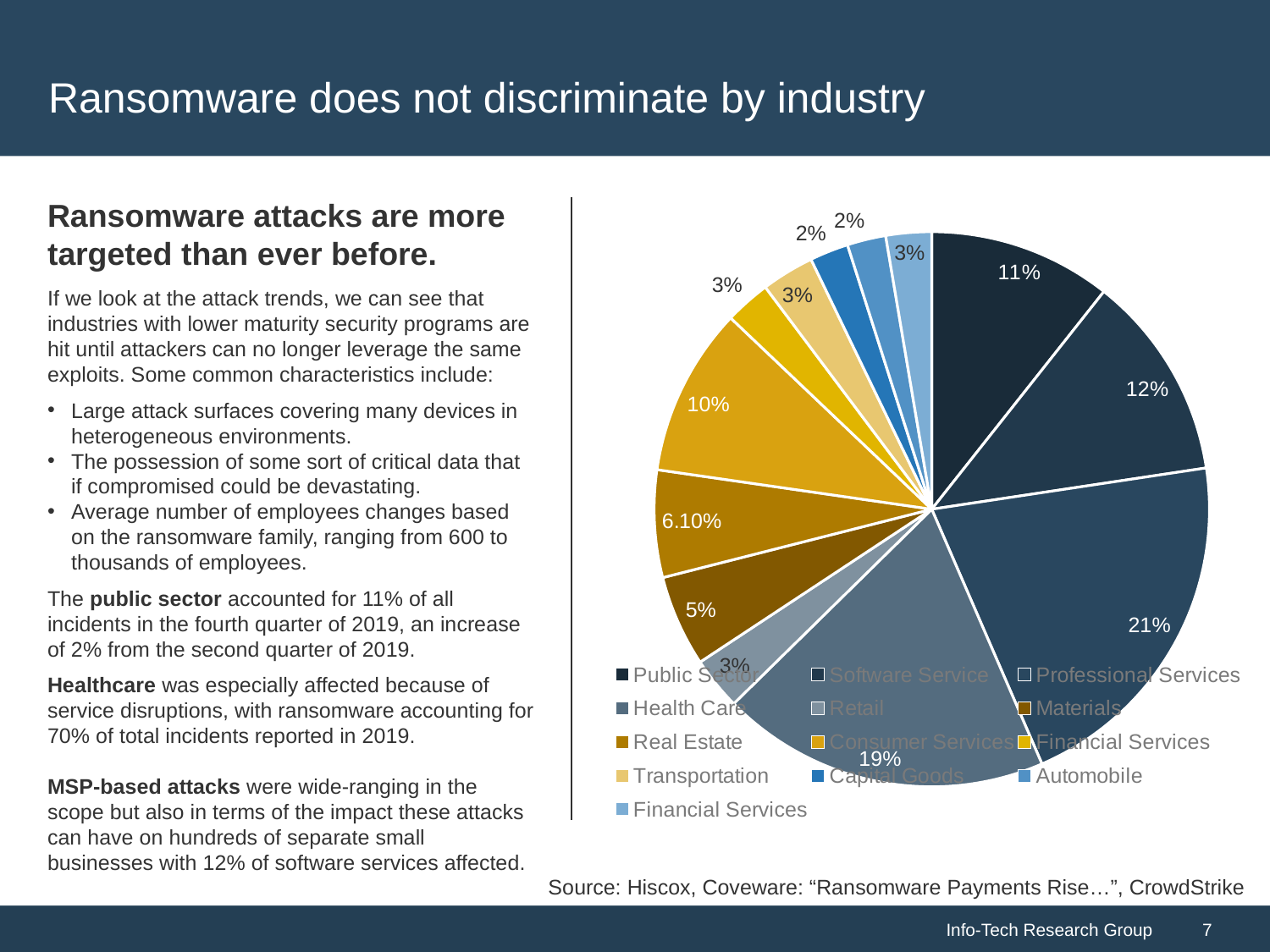
What percentage is shown for the Professional Services slice? 21% Which slice is larger, Public Sector or Software Service? Software Service What percentage is shown for the Software Service slice? 12% What is the smallest percentage labelled on the pie chart? 2% How many entries does the chart legend list? 13 What percentage of the pie does the Public Sector slice represent? 11% What is the difference between the Consumer Services slice (10%) and the Materials slice (5%)? 5% What percentage is shown for the Health Care slice? 19% What is the largest percentage labelled on the pie chart? 21% What is the difference between the Professional Services slice (21%) and the Health Care slice (19%)? 2% What kind of chart is shown on the slide? pie chart What percentage is shown for the Real Estate slice? 6.10%